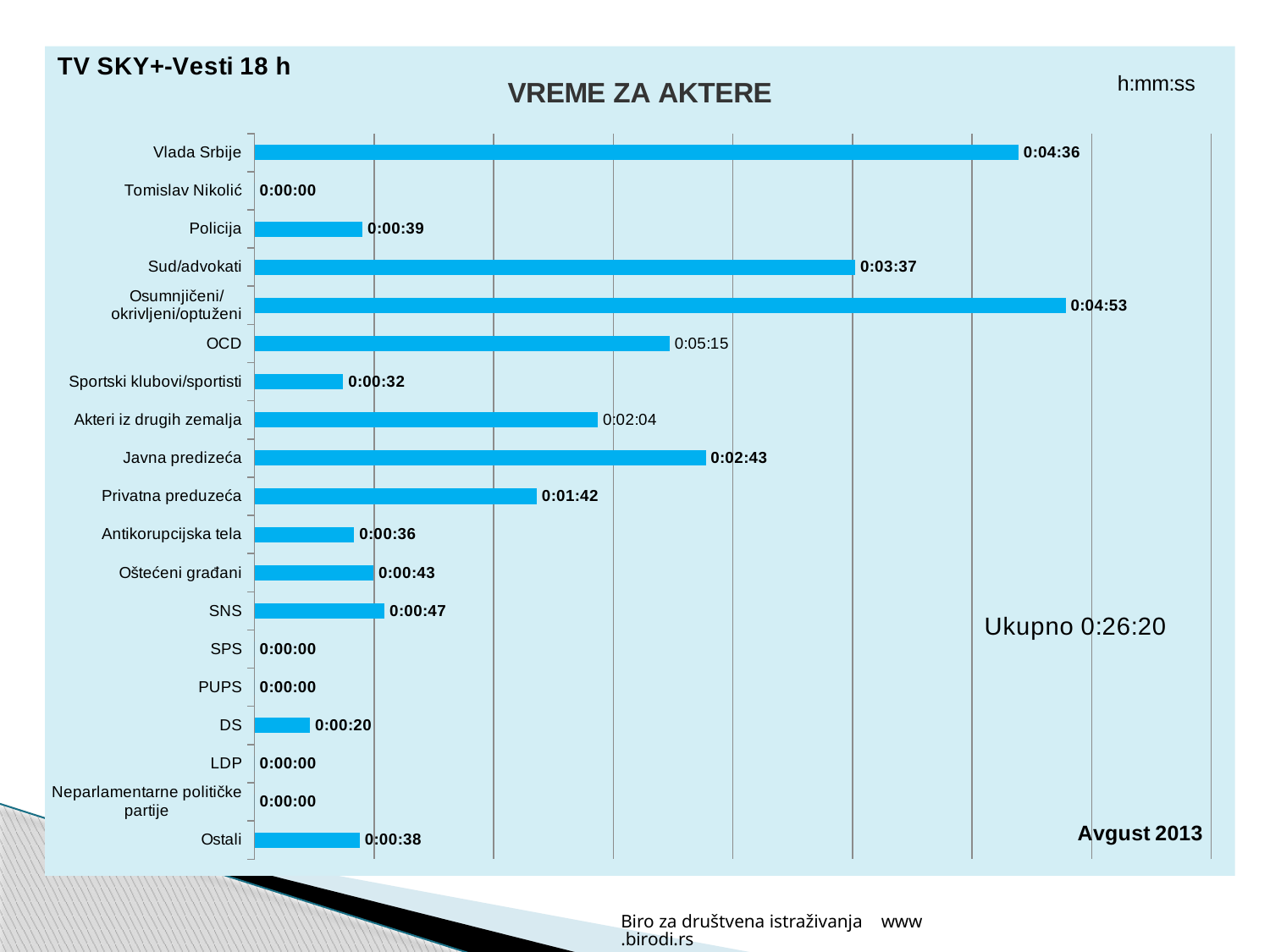
What is the value for DS? 0:00:20 What is the difference between the values for Vlada Srbije and Sud/advokati? 0:00:59 Which is larger, the value for SNS or the value for DS? SNS How many categories are plotted on the chart? 19 What is the difference between the values for Javna predizeća and Privatna preduzeća? 0:01:01 How many categories have a value of 0:00:00? 5 What is the value for Vlada Srbije? 0:04:36 What total (Ukupno) is printed on the chart? 0:26:20 What is the value for Osumnjičeni/okrivljeni/optuženi? 0:04:53 What kind of chart is shown on the slide? bar chart What is the value for Akteri iz drugih zemalja? 0:02:04 What is the value for Javna predizeća? 0:02:43